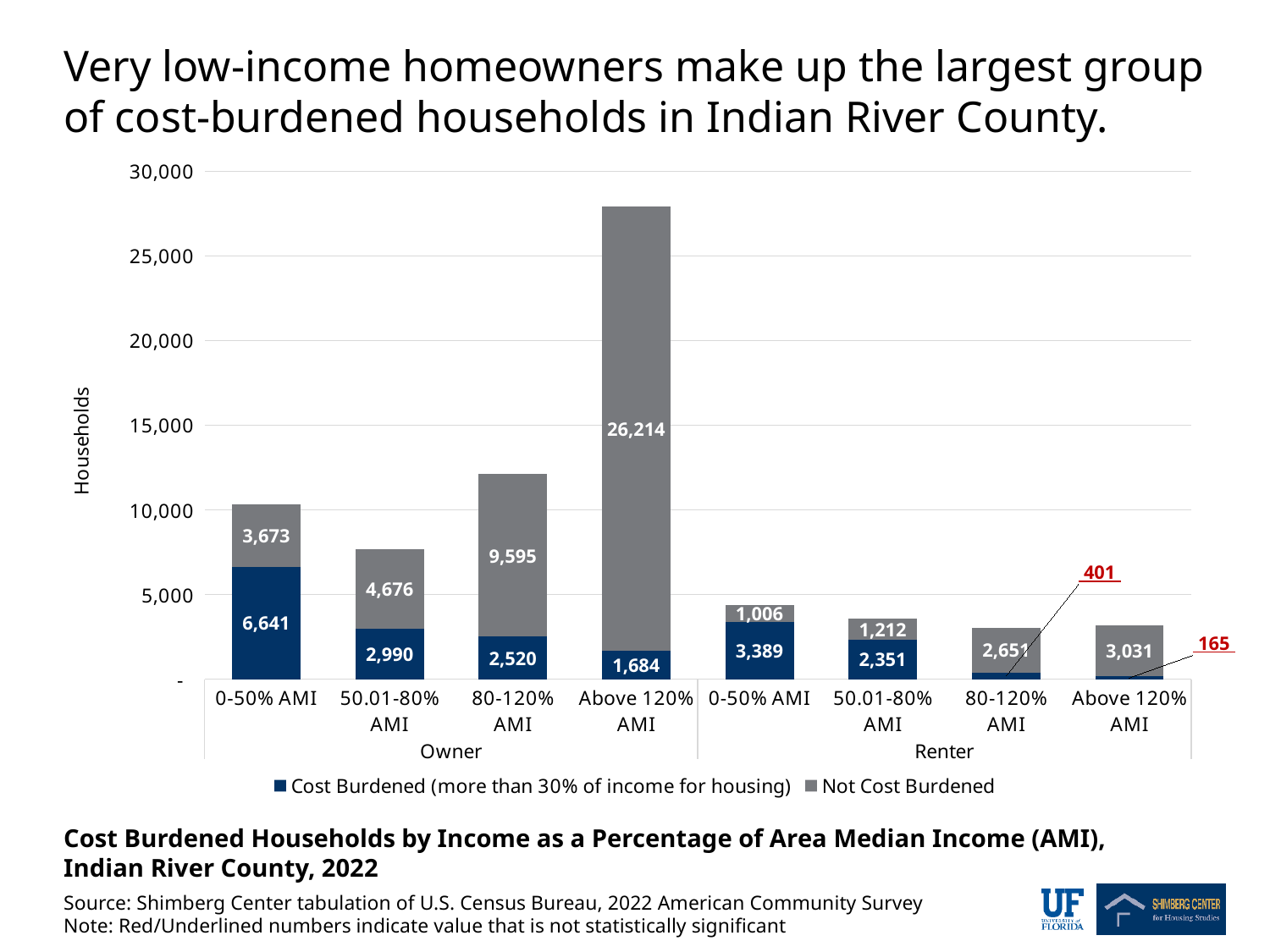
Which is larger: the number of not cost-burdened owner households at 50.01-80% AMI or at 80-120% AMI? 80-120% AMI Is the total height of the Owner Above 120% AMI bar greater or less than 25,000? greater What is the number of cost-burdened renter households in the 80-120% AMI category? 401 Which category has the largest number of cost-burdened households? Owner 0-50% AMI What type of chart is shown on the slide? Stacked bar chart What is the difference between cost-burdened owner households at 0-50% AMI and cost-burdened renter households at 0-50% AMI? 3,252 What is the total number of households in the Owner 0-50% AMI bar? 10,314 How many income categories are plotted across both the Owner and Renter groups? 8 What is the number of cost-burdened owner households in the 0-50% AMI category? 6,641 How many series does the legend list? 2 What is the number of not cost-burdened owner households in the Above 120% AMI category? 26,214 Which category has the smallest number of cost-burdened households? Renter Above 120% AMI